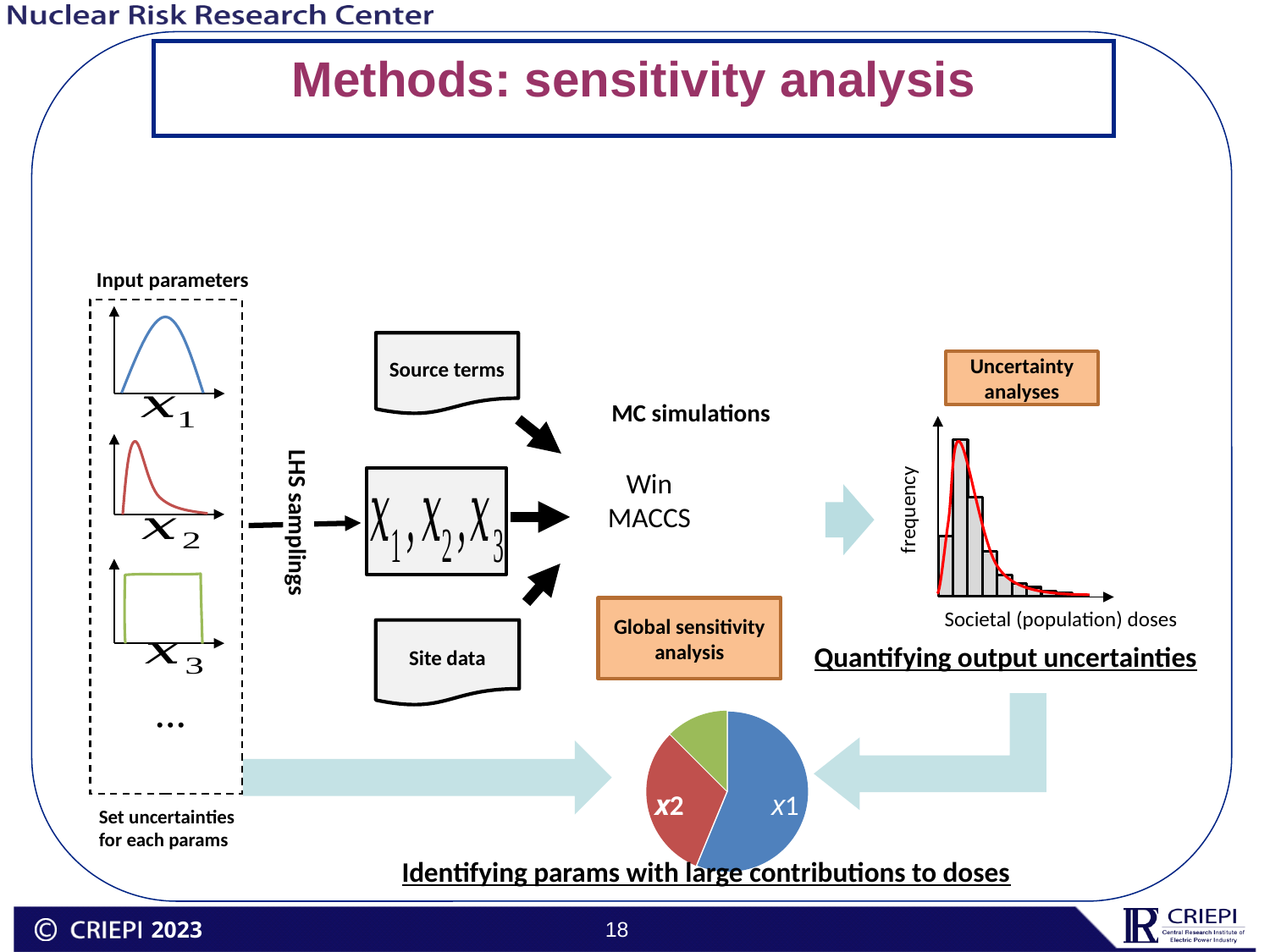
In the pie chart at the bottom of the slide, which slice is the smallest: x1, x2, or the unlabelled green slice? the green slice In the pie chart at the bottom of the slide, which labelled slice is the largest? x1 What is the x-axis label of the chart under the 'Uncertainty analyses' box? Societal (population) doses In the pie chart at the bottom of the slide, which is larger, the x1 slice or the x2 slice? x1 What kind of chart is shown at the bottom of the slide, below the 'Global sensitivity analysis' box? pie chart What colour is the x1 slice in the pie chart at the bottom of the slide? blue How many slices does the pie chart at the bottom of the slide have? 3 In the pie chart at the bottom of the slide, which is larger, the red x2 slice or the green slice? x2 What kind of chart is shown under the 'Uncertainty analyses' box on the right of the slide? bar chart